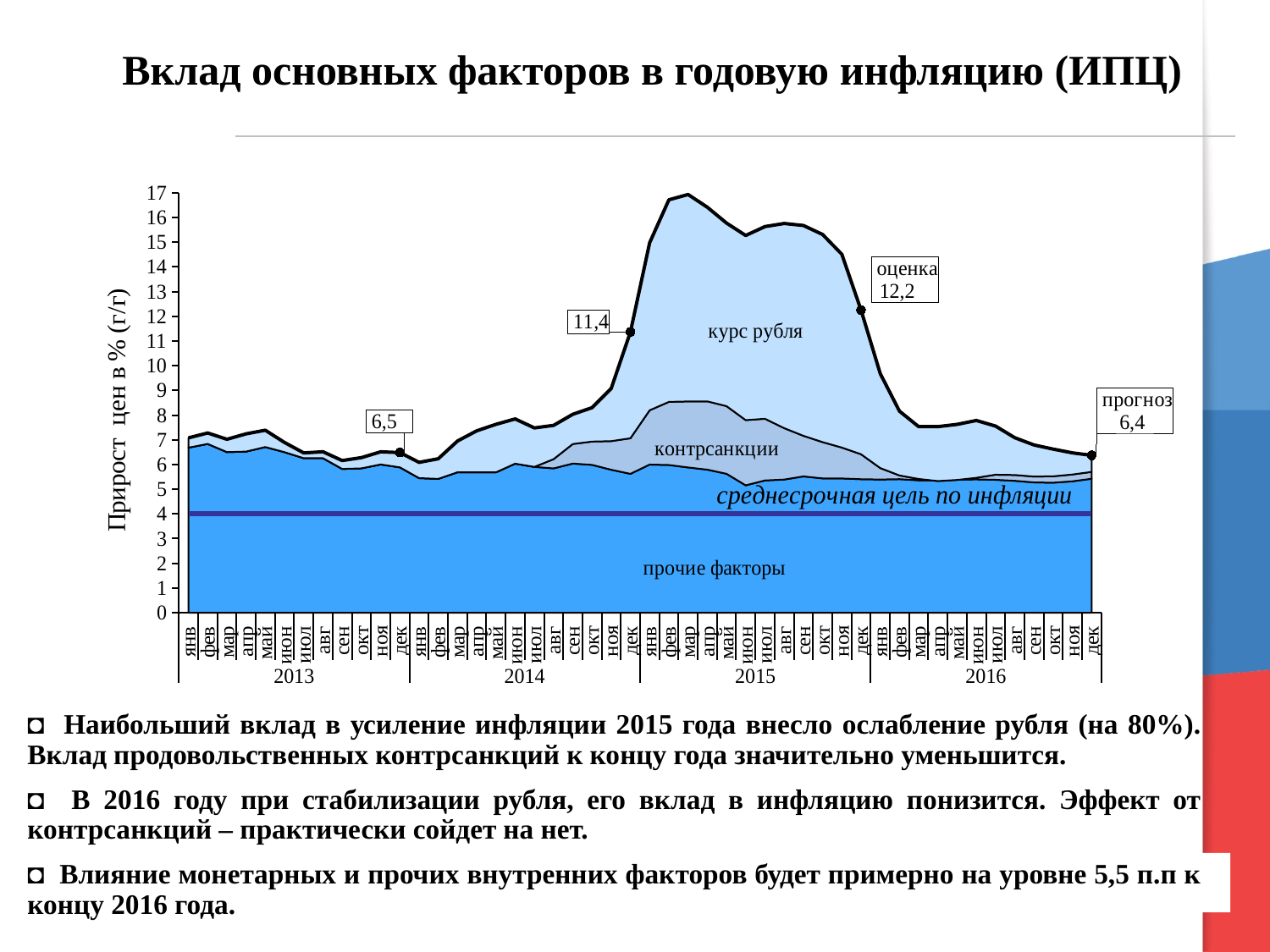
Which of the four labelled year-end points has the highest value? End of 2015 (оценка 12,2) What is the difference between the labelled end-2014 value (11,4) and the labelled end-2013 value (6,5)? 4,9 What is the labelled estimate (оценка) for annual inflation at the end of 2015? 12,2 By how much does the labelled end-2015 estimate (12,2) exceed the labelled end-2014 value (11,4)? 0,8 What is the labelled forecast (прогноз) for annual inflation at the end of 2016? 6,4 What kind of chart is shown on the slide? Stacked area chart What is the labelled value of annual inflation at the end of 2013 (дек 2013)? 6,5 At what level is the horizontal line marked 'среднесрочная цель по инфляции' drawn? 4 Which is larger: the labelled value for December 2014 or the forecast for December 2016? December 2014 (11,4) What is the labelled value of annual inflation at the end of 2014 (дек 2014)? 11,4 Is the peak of total annual inflation in early 2015 greater or less than 16? greater Does total annual inflation rise or fall from the end of 2015 to the end of 2016? Falls